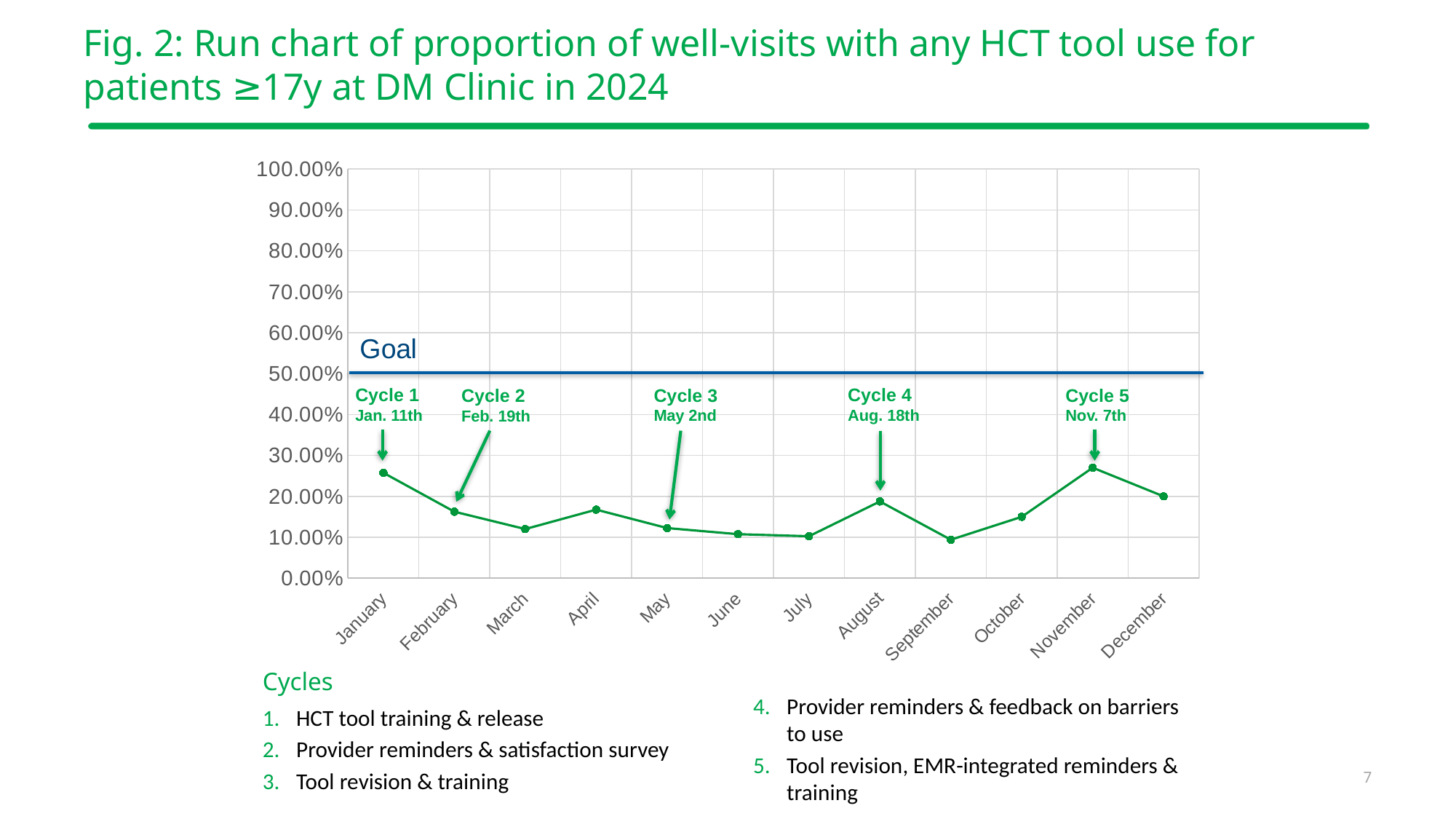
Is the value for November greater or less than 20.00%? greater Which month has the larger value, January or February? January Which month has the larger value, August or September? August Is the value for March greater or less than 20.00%? less At what percentage is the Goal line drawn on the chart? 50.00% How many months (data points) are plotted on the chart? 12 Is the value for June greater or less than 20.00%? less Which month has the larger value, November or March? November Do the values rise or fall from September to November? rise Do the values rise or fall from January to March? fall What kind of chart is shown on the slide? line chart